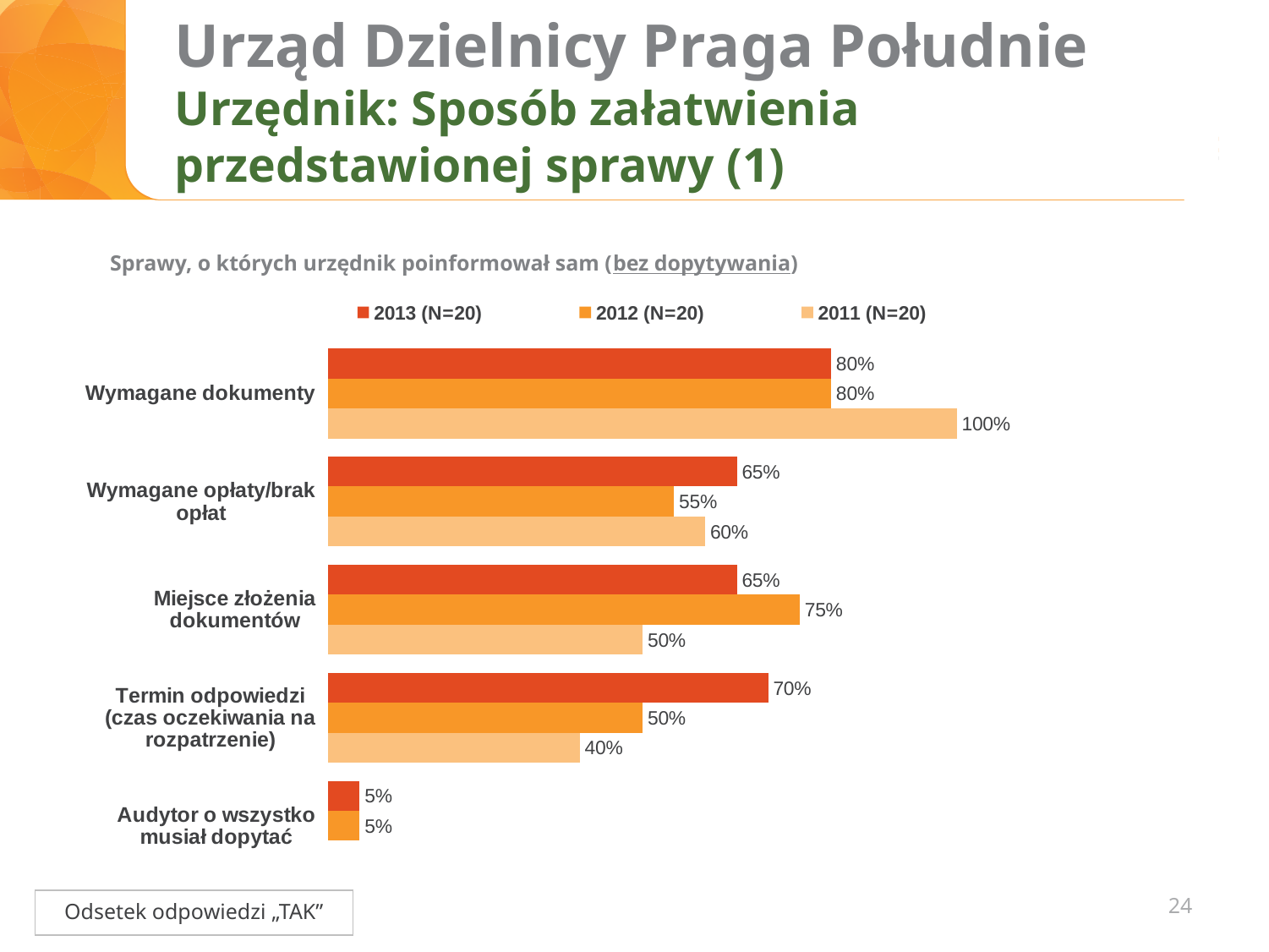
What is the value for 'Termin odpowiedzi (czas oczekiwania na rozpatrzenie)' in the 2013 (N=20) series? 70% How many categories are shown on the chart? 5 Which category has the lowest value in the 2012 (N=20) series? Audytor o wszystko musiał dopytać What is the difference between the 2013 (N=20) and 2011 (N=20) values for 'Termin odpowiedzi (czas oczekiwania na rozpatrzenie)'? 30% How many series does the legend list? 3 What is the value for 'Wymagane opłaty/brak opłat' in the 2011 (N=20) series? 60% What kind of chart is shown on the slide? bar chart What is the value for 'Miejsce złożenia dokumentów' in the 2012 (N=20) series? 75% What is the value for 'Wymagane dokumenty' in the 2011 (N=20) series? 100% Which category has the highest value in the 2013 (N=20) series? Wymagane dokumenty For 'Miejsce złożenia dokumentów', which series has the larger value: 2012 (N=20) or 2011 (N=20)? 2012 (N=20) What is the subtitle printed above the chart? Sprawy, o których urzędnik poinformował sam (bez dopytywania)